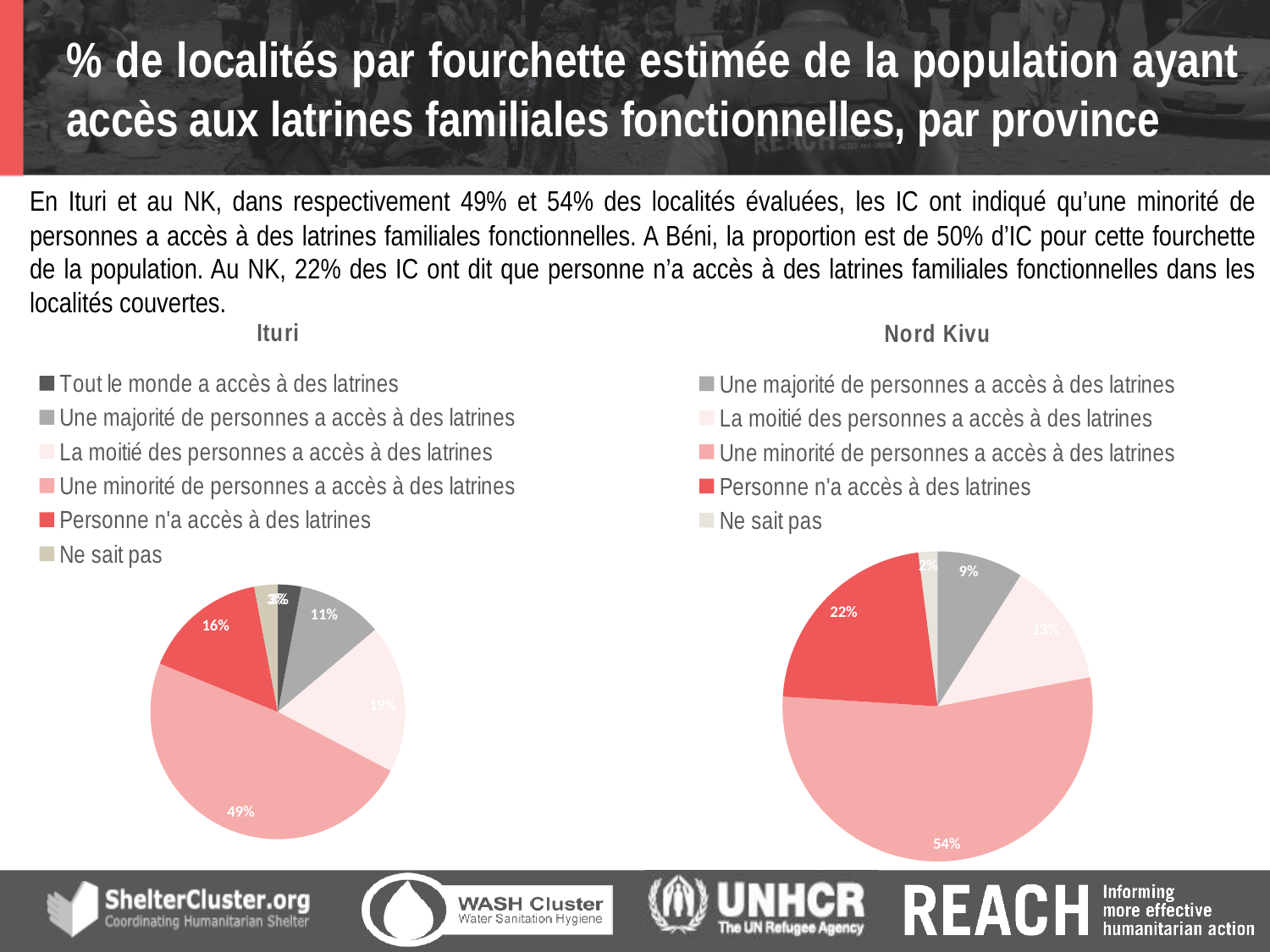
How many categories does the legend of the Nord Kivu chart list? 5 What type of chart is used for the Ituri and Nord Kivu data? Pie chart In the Nord Kivu pie chart, which category has the largest share? Une minorité de personnes a accès à des latrines In the Nord Kivu pie chart, what percentage is shown for "Une majorité de personnes a accès à des latrines"? 9% How many categories does the legend of the Ituri chart list? 6 In the Nord Kivu pie chart, what percentage is shown for "Personne n'a accès à des latrines"? 22% In the Nord Kivu pie chart, which category has the smallest share? Ne sait pas In the Ituri pie chart, which is larger: "Personne n'a accès à des latrines" or "Une majorité de personnes a accès à des latrines"? Personne n'a accès à des latrines In the Ituri pie chart, which category has the largest share? Une minorité de personnes a accès à des latrines In the Ituri pie chart, what percentage of localities is shown for "Une minorité de personnes a accès à des latrines"? 49% In the Ituri pie chart, what percentage is shown for "La moitié des personnes a accès à des latrines"? 19% What is the difference between the "Une minorité de personnes a accès à des latrines" share in Nord Kivu and in Ituri? 5 percentage points